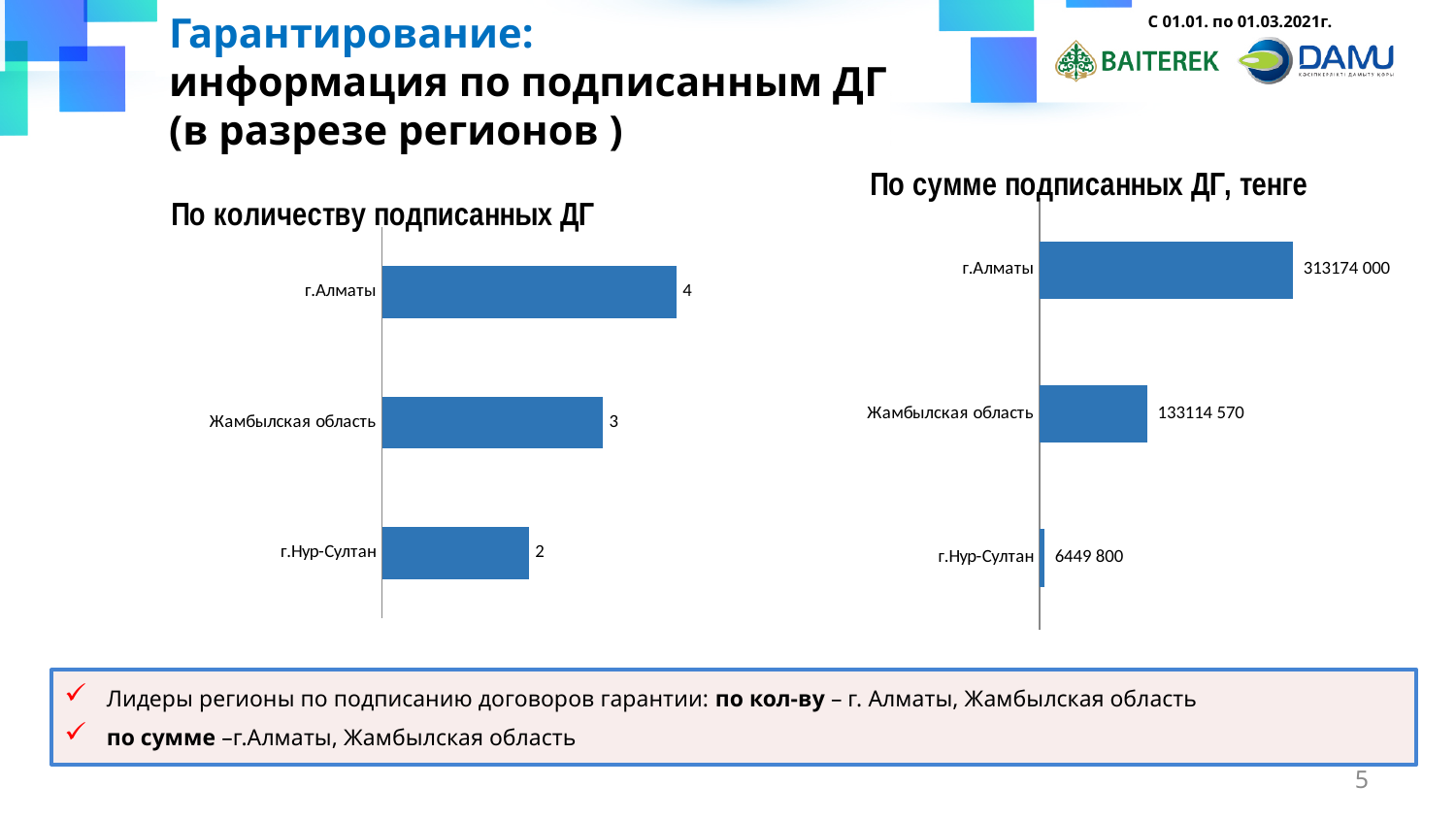
In the chart 'По количеству подписанных ДГ', what is the value for Жамбылская область? 3 In the chart 'По количеству подписанных ДГ', what is the value for г.Алматы? 4 In the chart 'По количеству подписанных ДГ', what is the difference between г.Алматы and г.Нур-Султан? 2 In the chart 'По сумме подписанных ДГ, тенге', what is the value for г.Алматы? 313174 000 In the chart 'По количеству подписанных ДГ', what is the value for г.Нур-Султан? 2 In the chart 'По сумме подписанных ДГ, тенге', what is the value for г.Нур-Султан? 6449 800 In the chart 'По сумме подписанных ДГ, тенге', which is larger: the value for Жамбылская область or for г.Нур-Султан? Жамбылская область What type of chart is 'По сумме подписанных ДГ, тенге'? Bar chart In the chart 'По сумме подписанных ДГ, тенге', which region has the highest value? г.Алматы In the chart 'По количеству подписанных ДГ', which region has the lowest value? г.Нур-Султан In the chart 'По сумме подписанных ДГ, тенге', what is the value for Жамбылская область? 133114 570 How many regions are shown in the chart 'По количеству подписанных ДГ'? 3